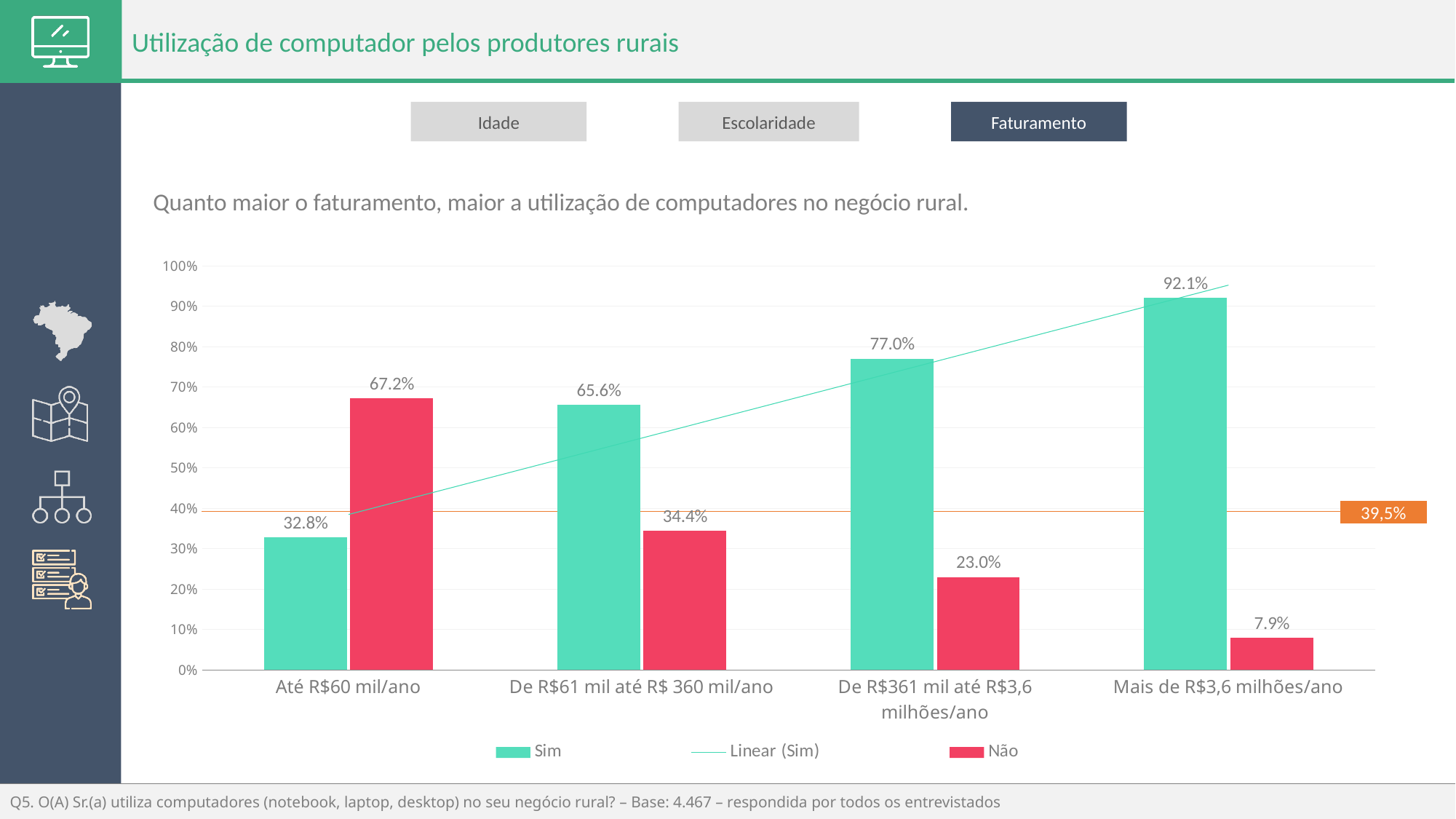
What is the 'Sim' value for 'De R$361 mil até R$3,6 milhões/ano'? 77.0% Is the 'Não' value for 'De R$361 mil até R$3,6 milhões/ano' greater or less than 30%? less How many entries does the legend list? 3 What is the 'Sim' value for the 'Até R$60 mil/ano' category? 32.8% Which category has the lowest 'Não' value? Mais de R$3,6 milhões/ano What kind of chart is shown on the slide? bar chart Which category has the highest 'Sim' value? Mais de R$3,6 milhões/ano Do the 'Sim' values rise or fall as revenue increases along the x axis? rise For 'De R$61 mil até R$ 360 mil/ano', which is larger: 'Sim' or 'Não'? Sim What is the difference between the 'Não' and 'Sim' values for 'Até R$60 mil/ano'? 34.4% How many revenue categories are shown on the x axis? 4 What is the 'Não' value for the 'Mais de R$3,6 milhões/ano' category? 7.9%